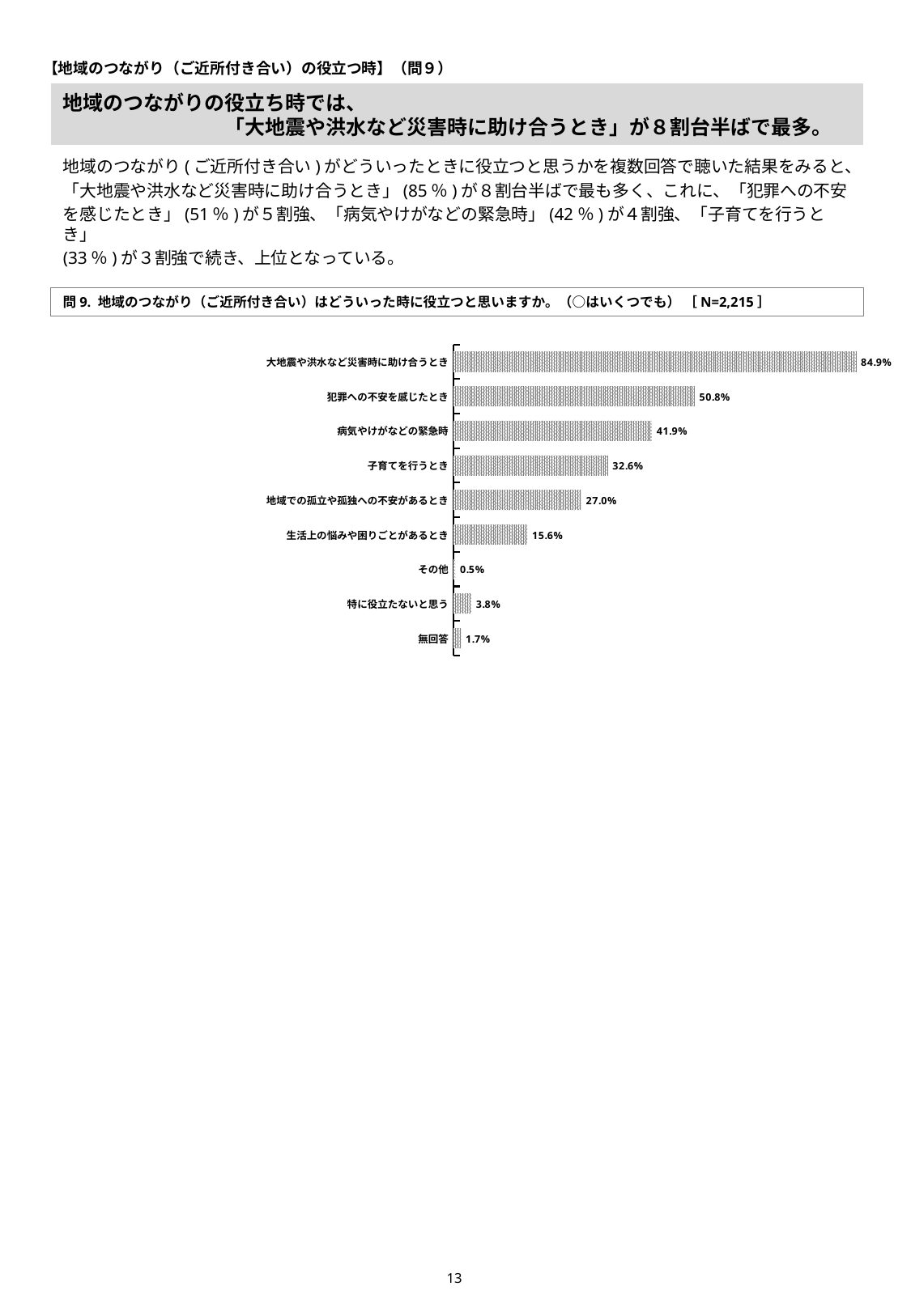
What is the value for 無回答? 1.7% What is the sample size (N) shown in the question box above the chart? N=2,215 What kind of chart is shown? Bar chart What is the value for 犯罪への不安を感じたとき? 50.8% Which category has the highest value? 大地震や洪水など災害時に助け合うとき What is the value for 子育てを行うとき? 32.6% Which is larger, 地域での孤立や孤独への不安があるとき or 生活上の悩みや困りごとがあるとき? 地域での孤立や孤独への不安があるとき What is the difference between 病気やけがなどの緊急時 and 子育てを行うとき? 9.3% Which category has the lowest value? その他 How many categories are shown in the chart? 9 What is the difference between 特に役立たないと思う and 無回答? 2.1% What is the value for 大地震や洪水など災害時に助け合うとき? 84.9%